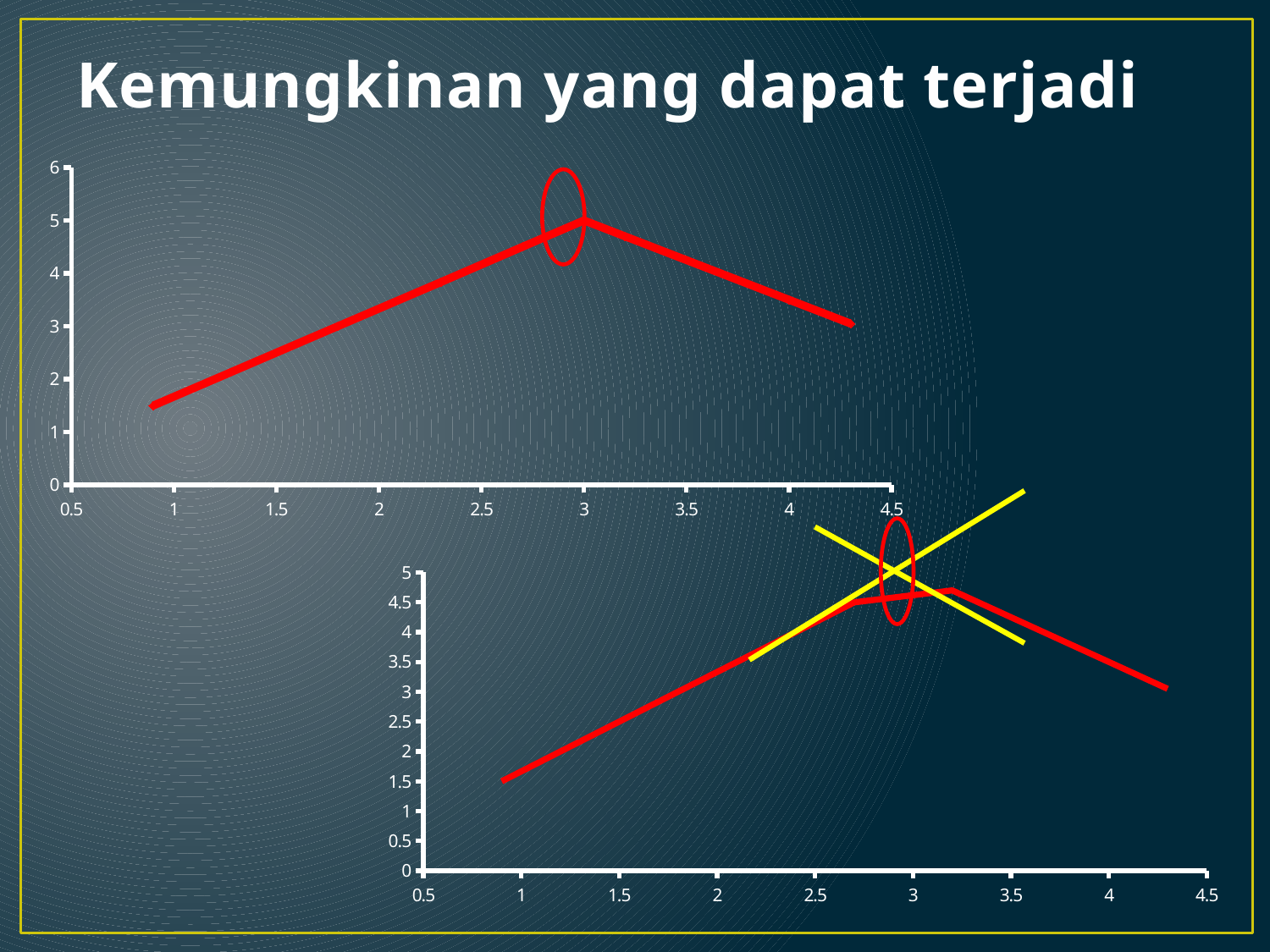
What kind of chart is the top chart on the slide? line chart In the top chart, is the value at the leftmost point of the red line greater or less than 2? less In the bottom chart, is the value at the leftmost point of the red line greater or less than 2? less What is the title of the slide containing the two charts? Kemungkinan yang dapat terjadi In the top chart, which is higher: the leftmost point or the rightmost point of the red line? the rightmost point In the top chart, do the values rise or fall as x increases from the leftmost point to the peak? rise In the top chart, is the value at the peak of the red line greater or less than 4? greater What colours are the two lines drawn on the bottom chart? red and yellow In the top chart, do the values rise or fall after the peak as x increases toward the right end? fall